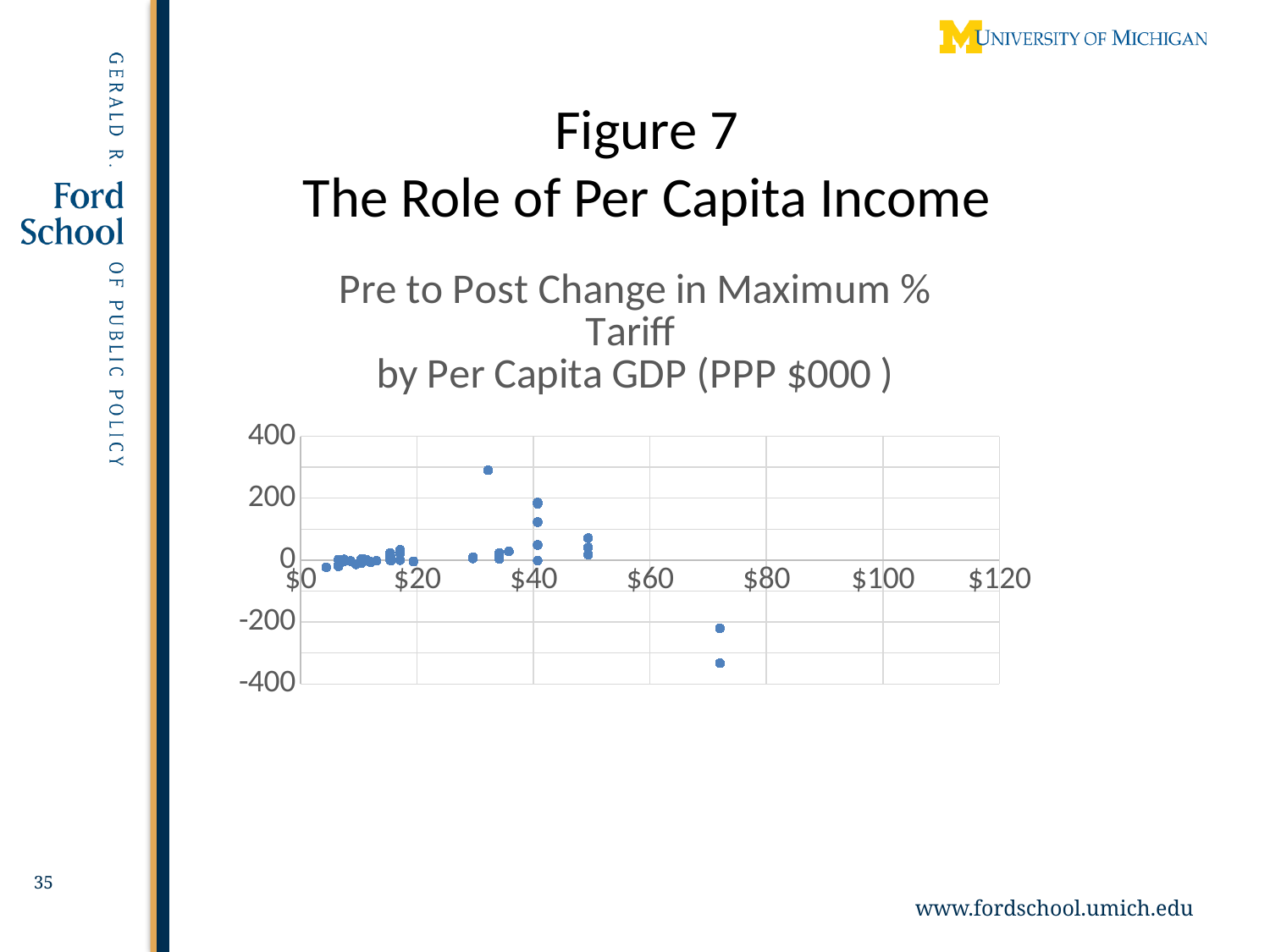
What kind of chart is shown on the slide? scatter chart Is the highest point plotted near $50 on the horizontal axis greater or less than 100? less Is the highest point plotted near $40 on the horizontal axis greater or less than 100? greater Are the two points plotted near $70 on the horizontal axis above or below 0? below Which is larger: the highest point plotted near $30 on the horizontal axis or the highest point plotted near $40? the point near $30 What is the highest value shown on the vertical axis of the chart? 400 What is the title of the chart? Pre to Post Change in Maximum % Tariff by Per Capita GDP (PPP $000 )